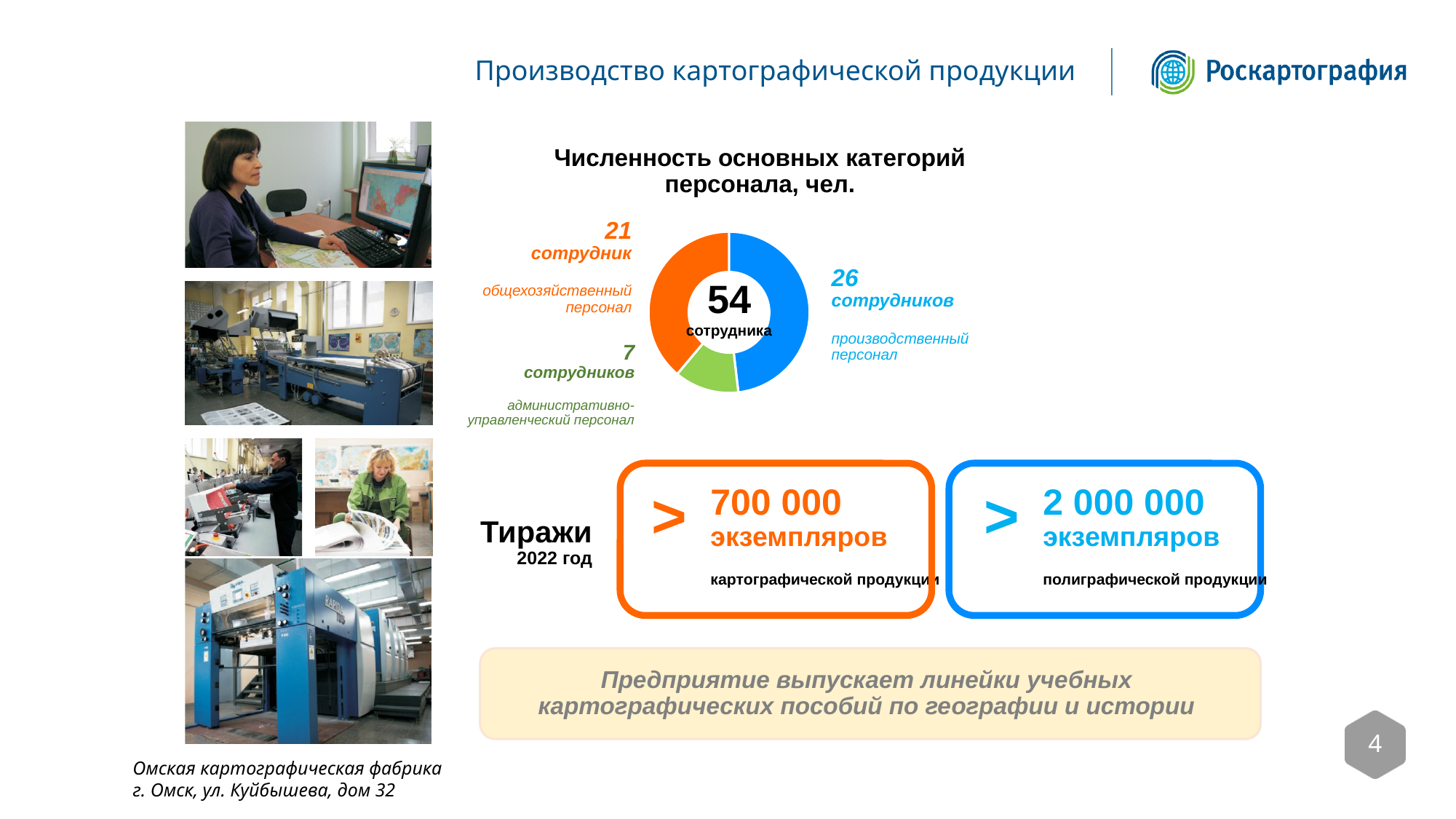
What colour is the slice for производственный персонал in the donut chart? Blue Which personnel category has the largest number of employees? производственный персонал Which personnel category has the smallest number of employees? административно-управленческий персонал How many personnel categories are shown in the donut chart? 3 What type of chart is used to show the headcount of main personnel categories? Pie (donut) chart How many employees are in the административно-управленческий персонал category? 7 Which category has more employees: общехозяйственный персонал or административно-управленческий персонал? общехозяйственный персонал What is the difference in headcount between производственный персонал and общехозяйственный персонал? 5 How many employees are in the общехозяйственный персонал category? 21 What is the title of the donut chart? Численность основных категорий персонала, чел. How many employees are in the производственный персонал category? 26 What total number of employees is shown in the centre of the donut chart? 54